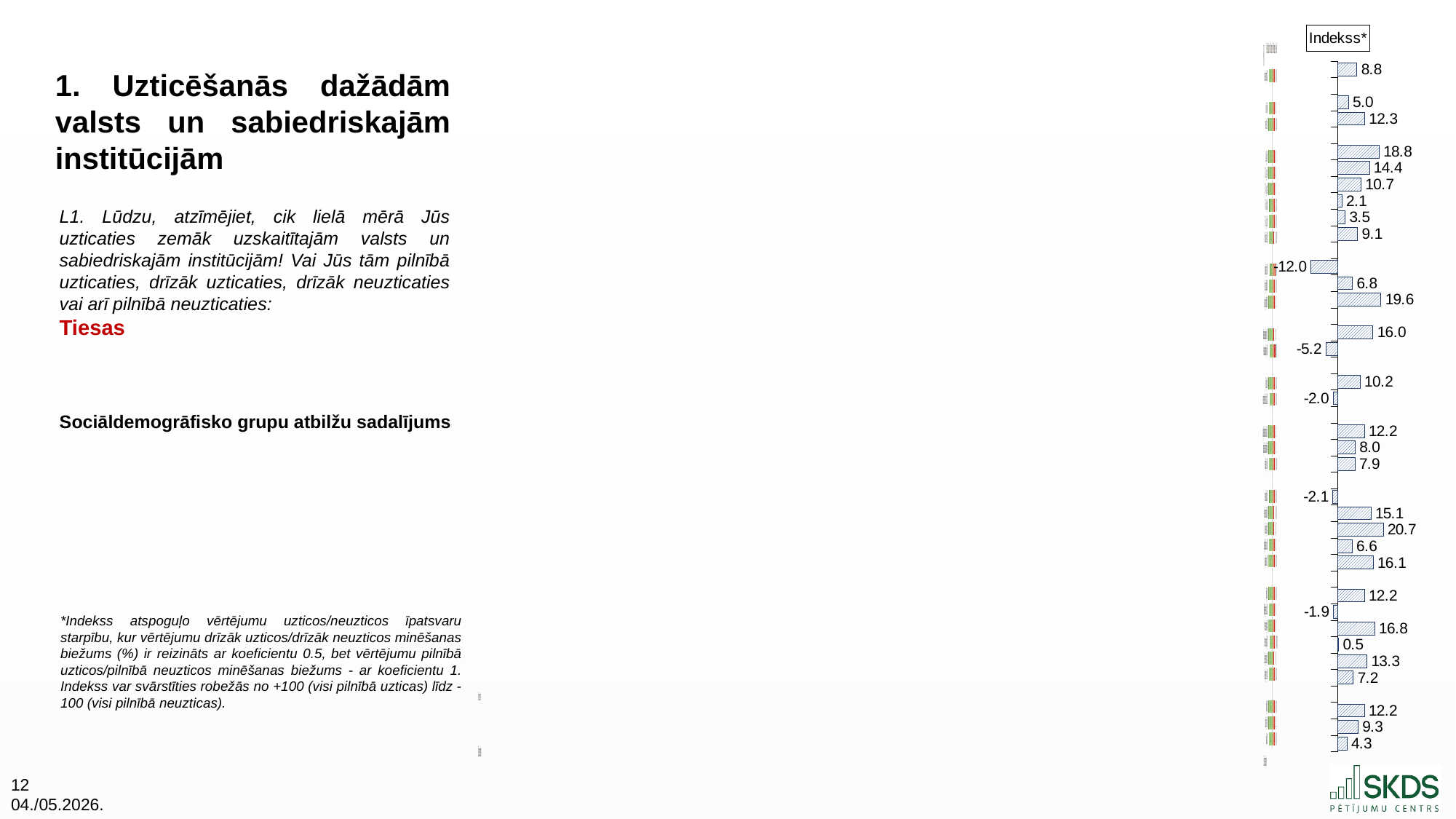
What kind of chart is the 'Indekss*' chart on the right side of the slide? bar chart What is the highest index value shown in the 'Indekss*' chart? 20.7 What is the title printed above the index bar chart on the right of the slide? Indekss* In the 'Indekss*' chart, which is larger: the value 19.6 or the value 16.0? 19.6 What is the lowest index value shown in the 'Indekss*' chart? -12.0